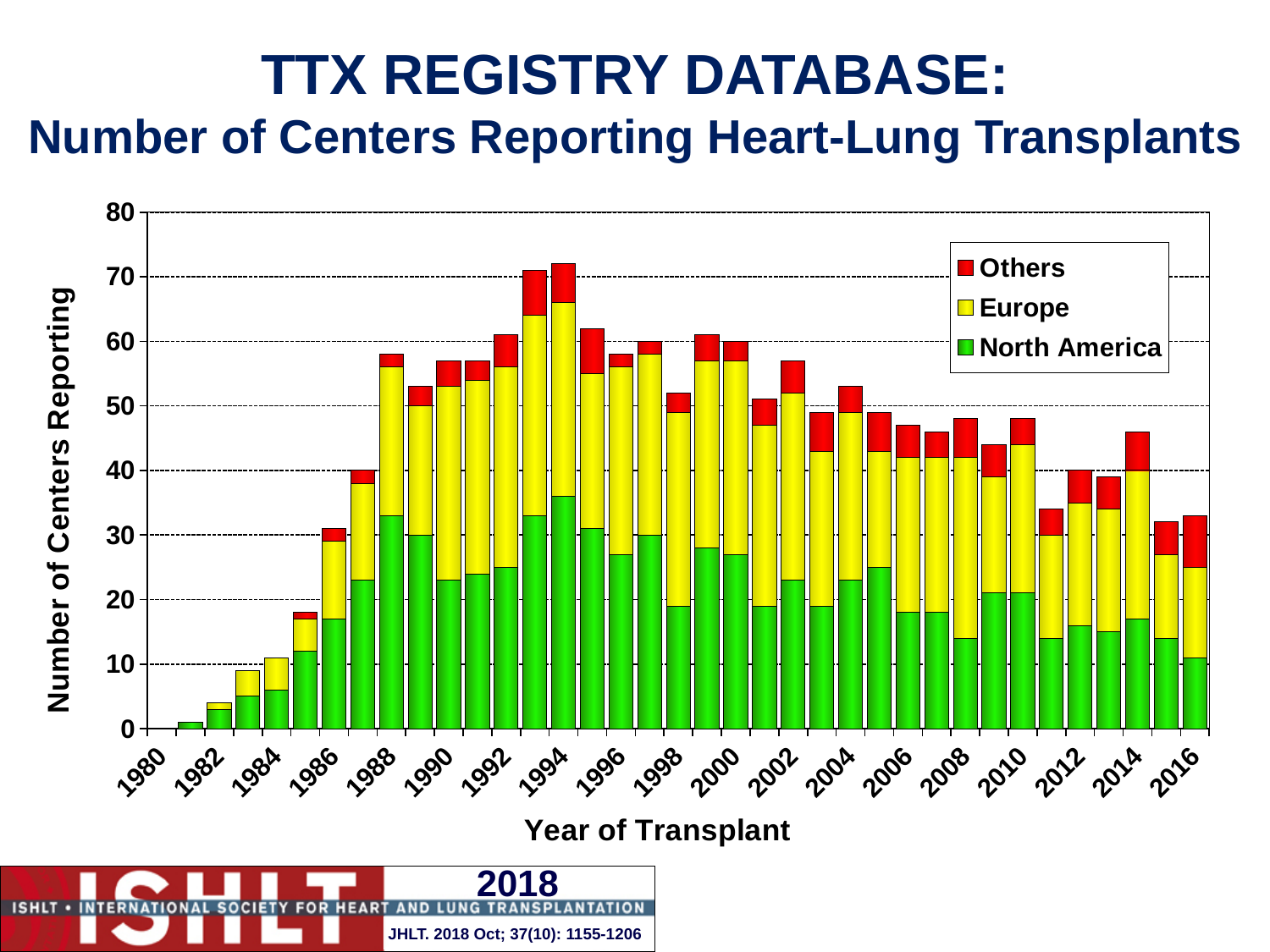
How many series does the legend list? 3 Is the total number of centers reporting in 1980 greater or less than 10? less What is the title of the y axis? Number of Centers Reporting Is the total number of centers reporting in 2011 greater or less than 40? less Do the total numbers of centers reporting rise or fall from 1980 to 1988? rise Is the total number of centers reporting in 1988 greater or less than 50? greater Which year has the lowest total number of centers reporting? 1980 What kind of chart is shown on the slide? Stacked bar chart Which series are listed in the legend? Others, Europe, North America Which year has the larger North America value, 1994 or 2016? 1994 Which year has the larger total number of centers reporting, 1988 or 2016? 1988